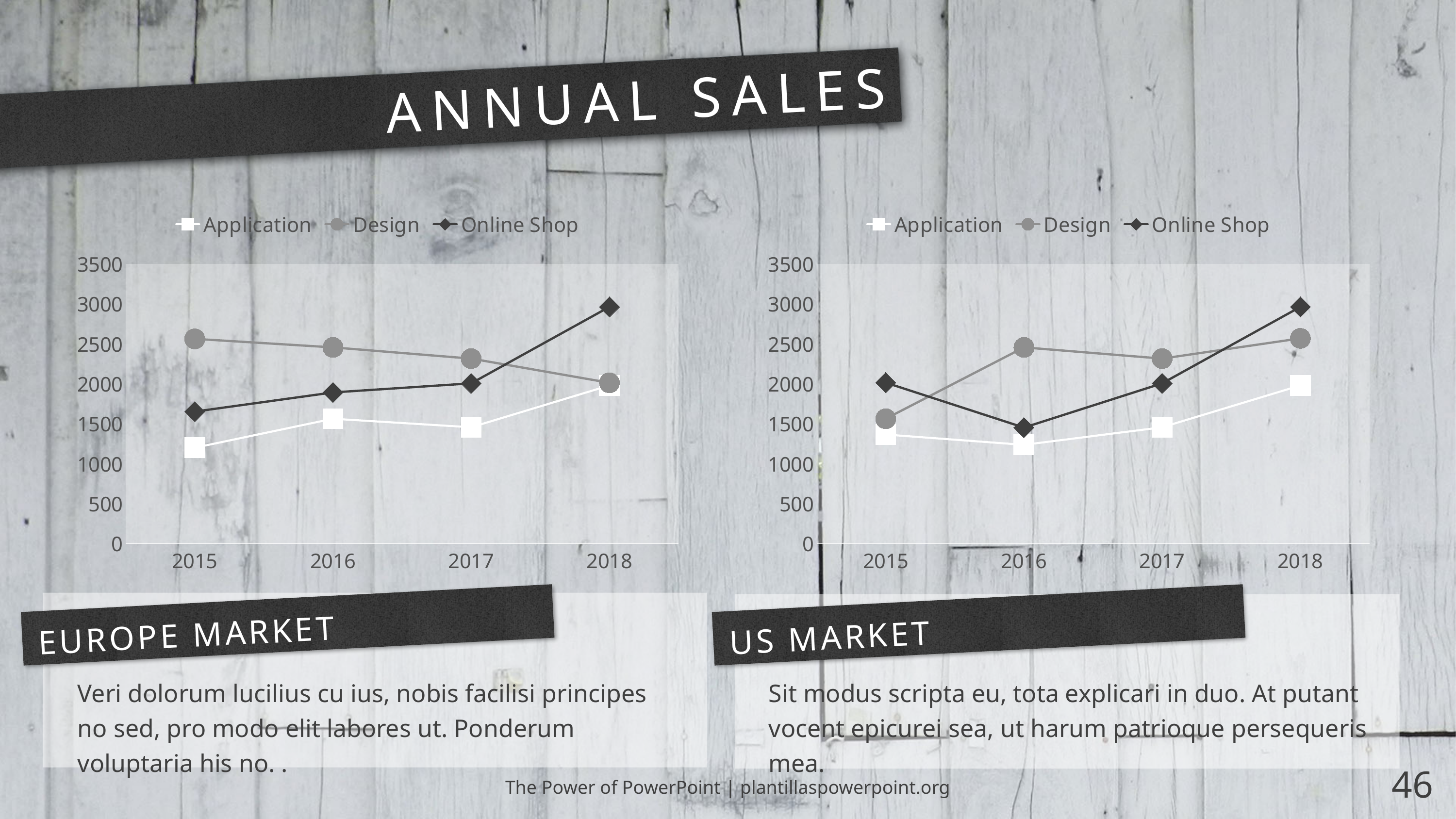
How many series does the legend of the US Market chart list? 3 In the Europe Market chart, which year has the lowest Design value? 2018 In the Europe Market chart, which year has the highest Online Shop value? 2018 What kind of chart is the Europe Market chart? line chart In the Europe Market chart, is the Online Shop value for 2018 greater or less than 2500? greater In the US Market chart, is the Design value for 2015 greater or less than 2000? less In the Europe Market chart, which is larger in 2015: Design or Online Shop? Design In the US Market chart, is the Online Shop value for 2016 greater or less than 2000? less In the Europe Market chart, does the Design series rise or fall from 2015 to 2018? fall How many years are shown on the x axis of the Europe Market chart? 4 In the US Market chart, which is larger in 2016: Design or Online Shop? Design